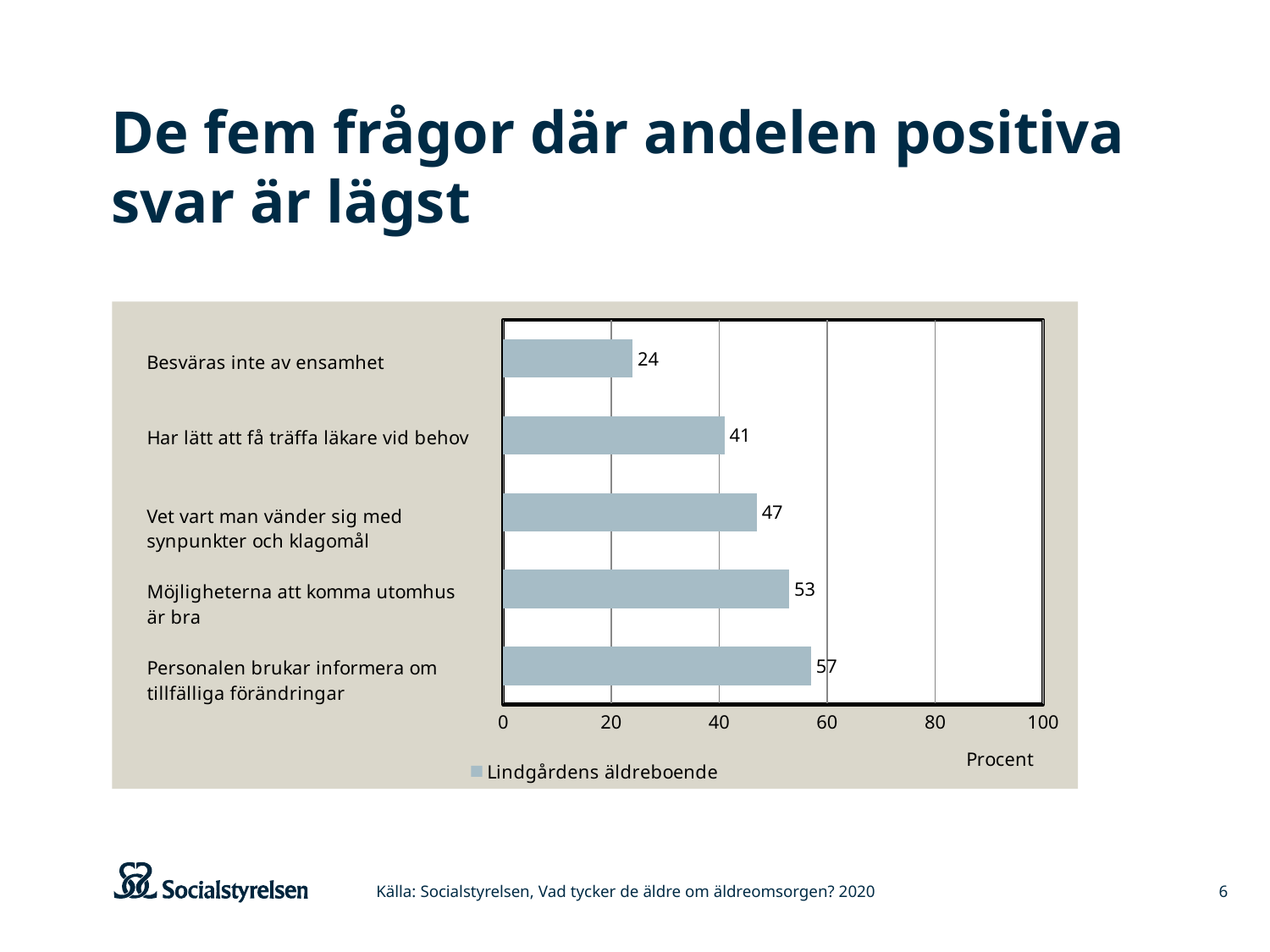
What kind of chart is shown on the slide? bar chart What is the difference between the values for "Personalen brukar informera om tillfälliga förändringar" and "Besväras inte av ensamhet"? 33 Which category has the lowest value? Besväras inte av ensamhet What is the value for "Möjligheterna att komma utomhus är bra"? 53 Is the value for "Har lätt att få träffa läkare vid behov" greater or less than 60? less What is the value for "Besväras inte av ensamhet"? 24 What series does the legend list? Lindgårdens äldreboende Which is larger: the value for "Möjligheterna att komma utomhus är bra" or the value for "Vet vart man vänder sig med synpunkter och klagomål"? Möjligheterna att komma utomhus är bra What is the difference between the values for "Vet vart man vänder sig med synpunkter och klagomål" and "Har lätt att få träffa läkare vid behov"? 6 What is the value for "Har lätt att få träffa läkare vid behov"? 41 Which category has the highest value? Personalen brukar informera om tillfälliga förändringar How many categories are shown in the chart? 5